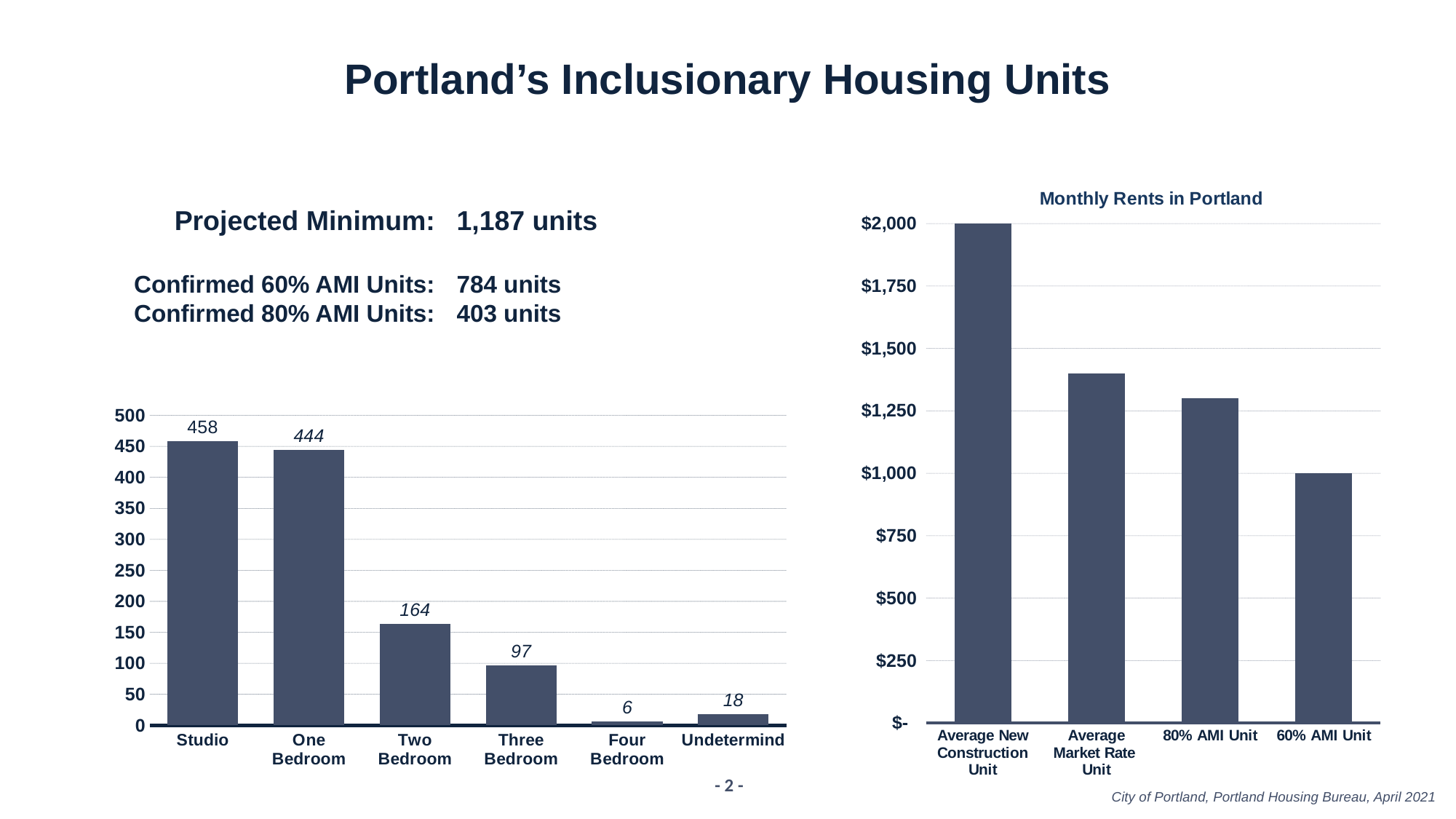
In the Monthly Rents in Portland chart, what is the value for 60% AMI Unit? $1,000 How many categories are shown in the left chart? 6 In the left chart, how many Studio units are shown? 458 In the left chart, which category has the highest value? Studio In the left chart, what is the value for Two Bedroom? 164 In the Monthly Rents in Portland chart, what is the value for Average New Construction Unit? $2,000 What kind of chart is the Monthly Rents in Portland chart? Bar chart In the left chart, which is larger, Three Bedroom or Undetermind? Three Bedroom In the left chart, what is the difference between the Studio and One Bedroom values? 14 In the left chart, which category has the lowest value? Four Bedroom In the Monthly Rents in Portland chart, is the value for Average Market Rate Unit greater or less than $1,250? greater In the Monthly Rents in Portland chart, do the values rise or fall from left to right? Fall